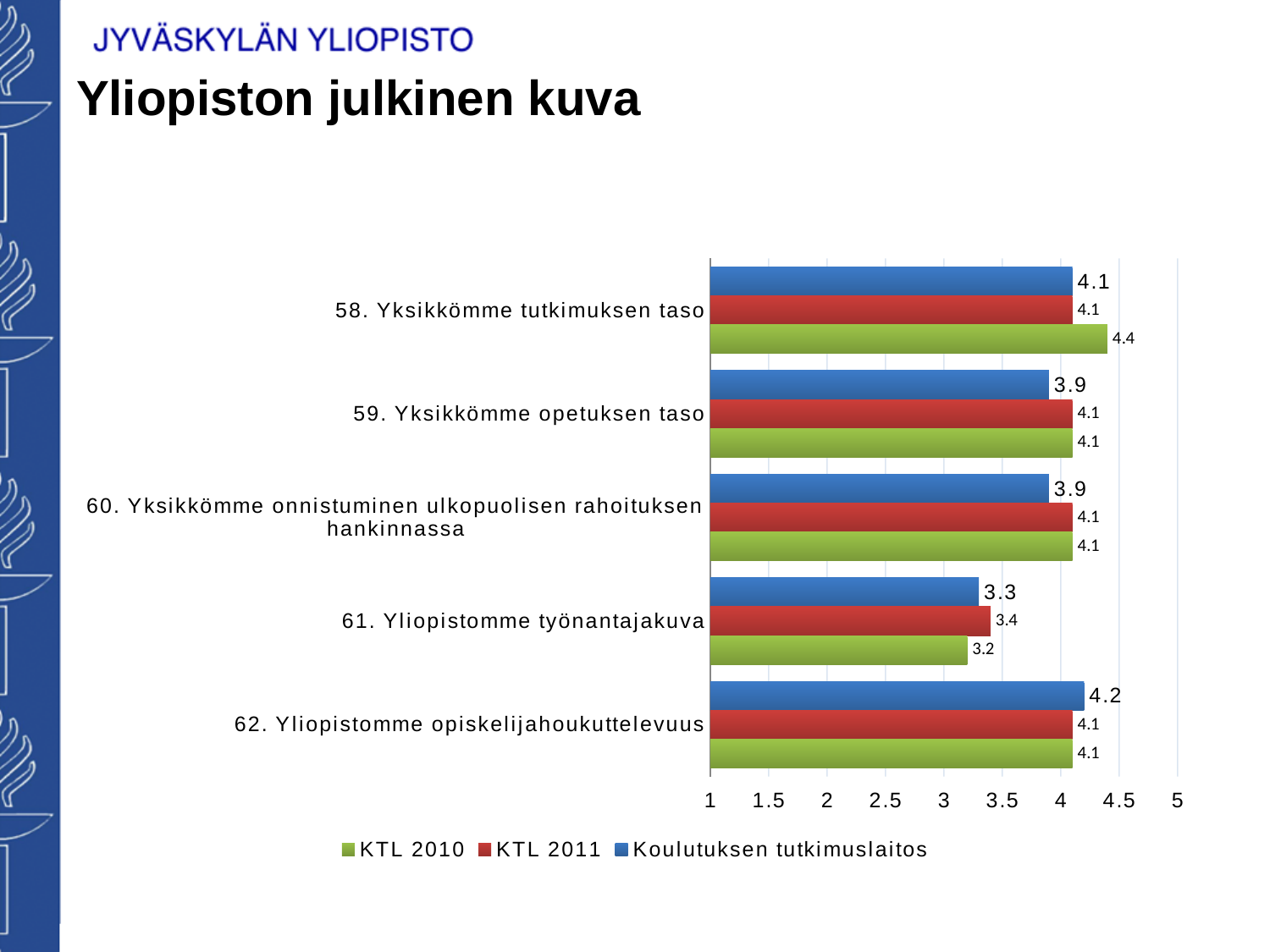
What is the Koulutuksen tutkimuslaitos value for "61. Yliopistomme työnantajakuva"? 3.3 How many series does the legend list? 3 For "61. Yliopistomme työnantajakuva", which is larger: the KTL 2011 value or the KTL 2010 value? KTL 2011 Which category has the highest KTL 2010 value? 58. Yksikkömme tutkimuksen taso How many categories are shown on the chart? 5 Which series is shown in blue in the legend? Koulutuksen tutkimuslaitos What is the difference between the KTL 2010 value and the Koulutuksen tutkimuslaitos value for "58. Yksikkömme tutkimuksen taso"? 0.3 What is the KTL 2011 value for "59. Yksikkömme opetuksen taso"? 4.1 Which category has the lowest KTL 2010 value? 61. Yliopistomme työnantajakuva What kind of chart is shown on the slide? bar chart What is the Koulutuksen tutkimuslaitos value for "62. Yliopistomme opiskelijahoukuttelevuus"? 4.2 What is the KTL 2010 value for "58. Yksikkömme tutkimuksen taso"? 4.4